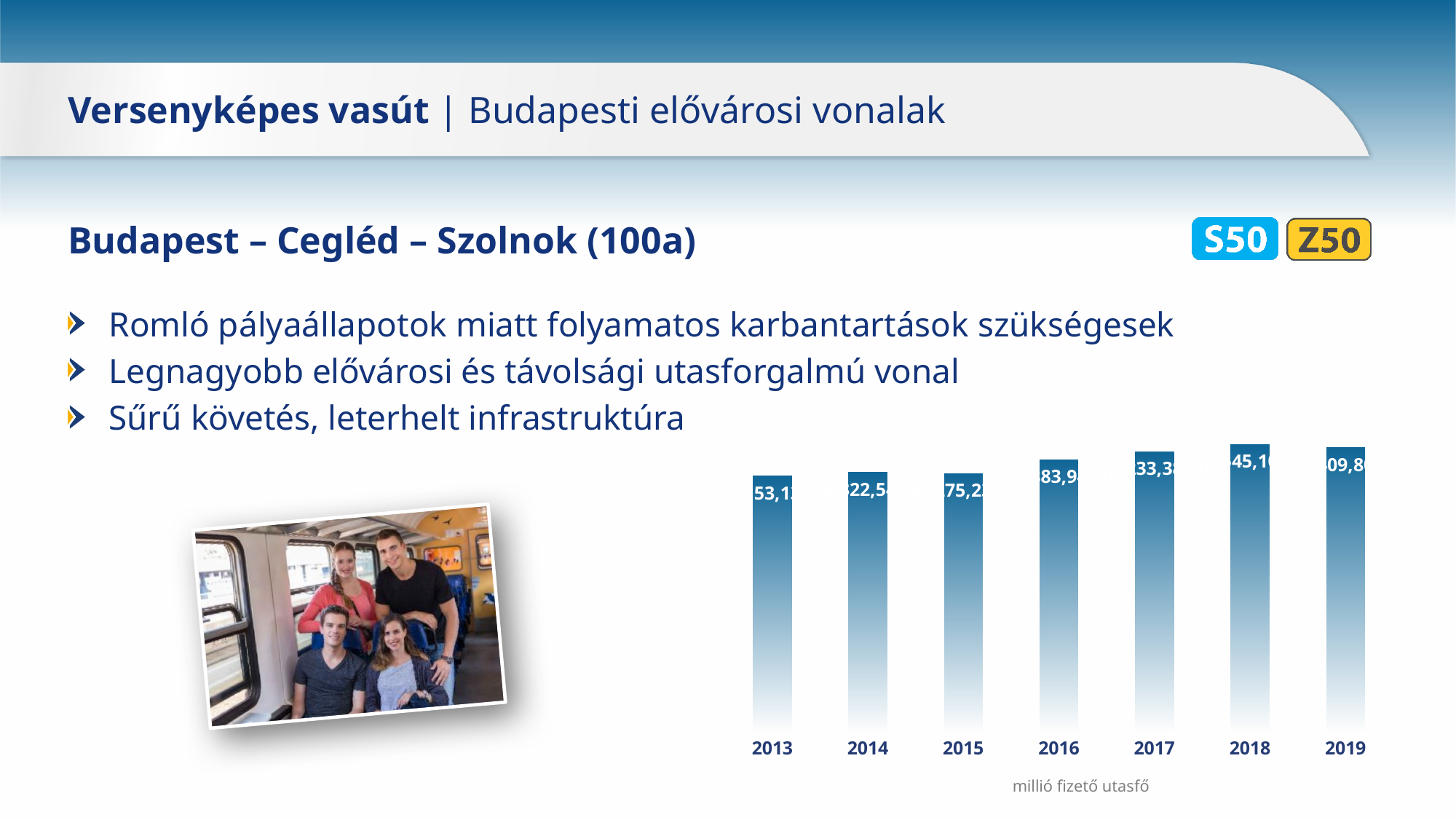
What is the first year shown on the x axis of the chart? 2013 How many years are shown on the x axis of the chart? 7 Is the bar for 2015 taller or shorter than the bar for 2017? shorter Is the bar for 2014 taller or shorter than the bar for 2018? shorter Is the bar for 2016 taller or shorter than the bar for 2013? taller What kind of chart is shown on the slide? bar chart Do the bar values generally rise or fall from 2013 to 2019? rise Which year has the lowest bar in the chart? 2013 What unit is given below the chart? millió fizető utasfő